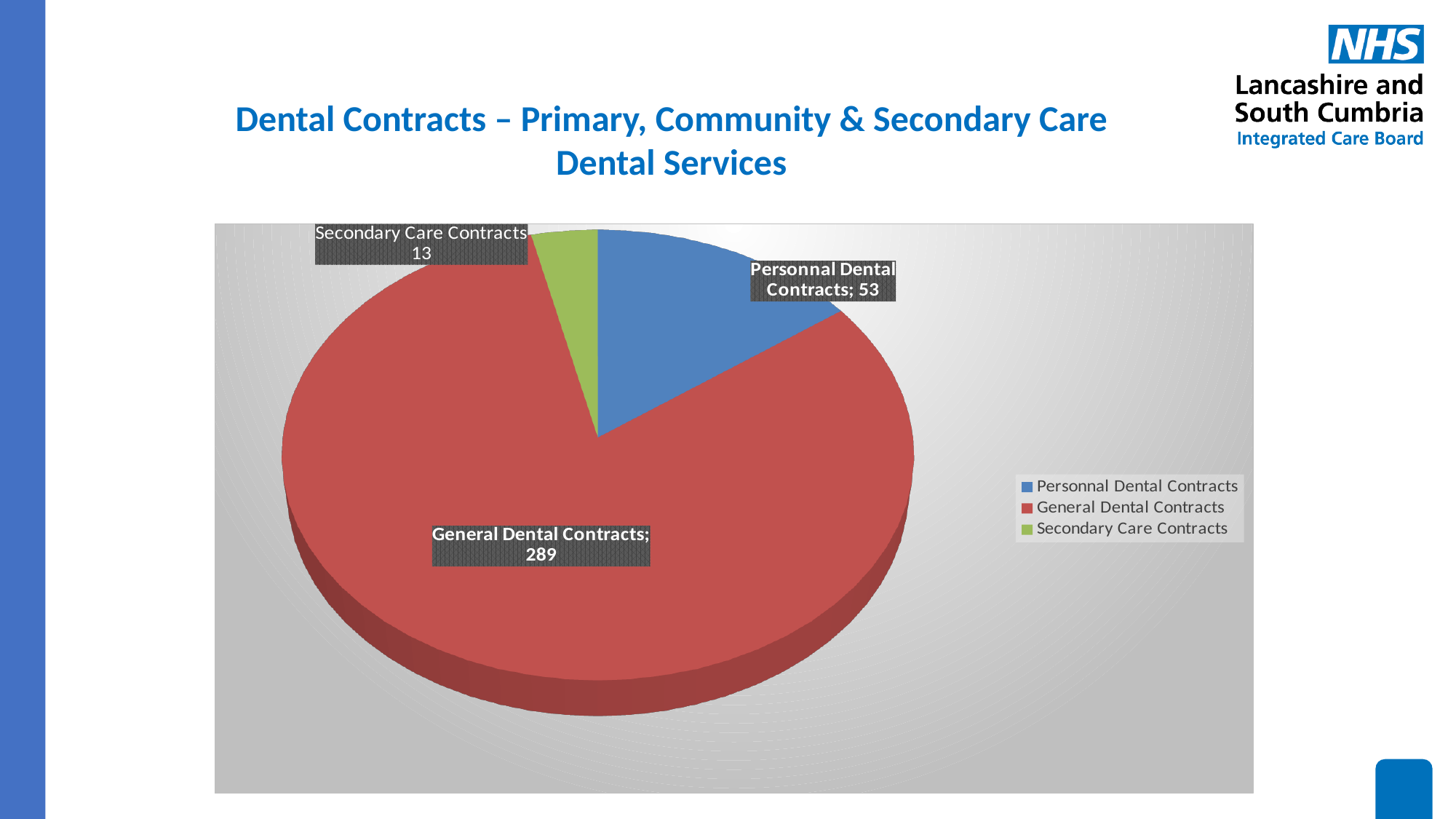
What is the total number of contracts across all three slices of the pie? 355 What is the difference between the number of Personnal Dental Contracts and Secondary Care Contracts? 40 How many General Dental Contracts are shown in the pie chart? 289 What is the difference between the number of General Dental Contracts and Personnal Dental Contracts? 236 Which category has the largest slice of the pie? General Dental Contracts What colour is the General Dental Contracts slice in the pie chart? Red How many categories does the pie chart show? 3 Which category has the smallest slice of the pie? Secondary Care Contracts What kind of chart is shown on the slide? Pie chart What is the value shown for Secondary Care Contracts? 13 What is the value shown for Personnal Dental Contracts? 53 Which is larger, Personnal Dental Contracts or Secondary Care Contracts? Personnal Dental Contracts